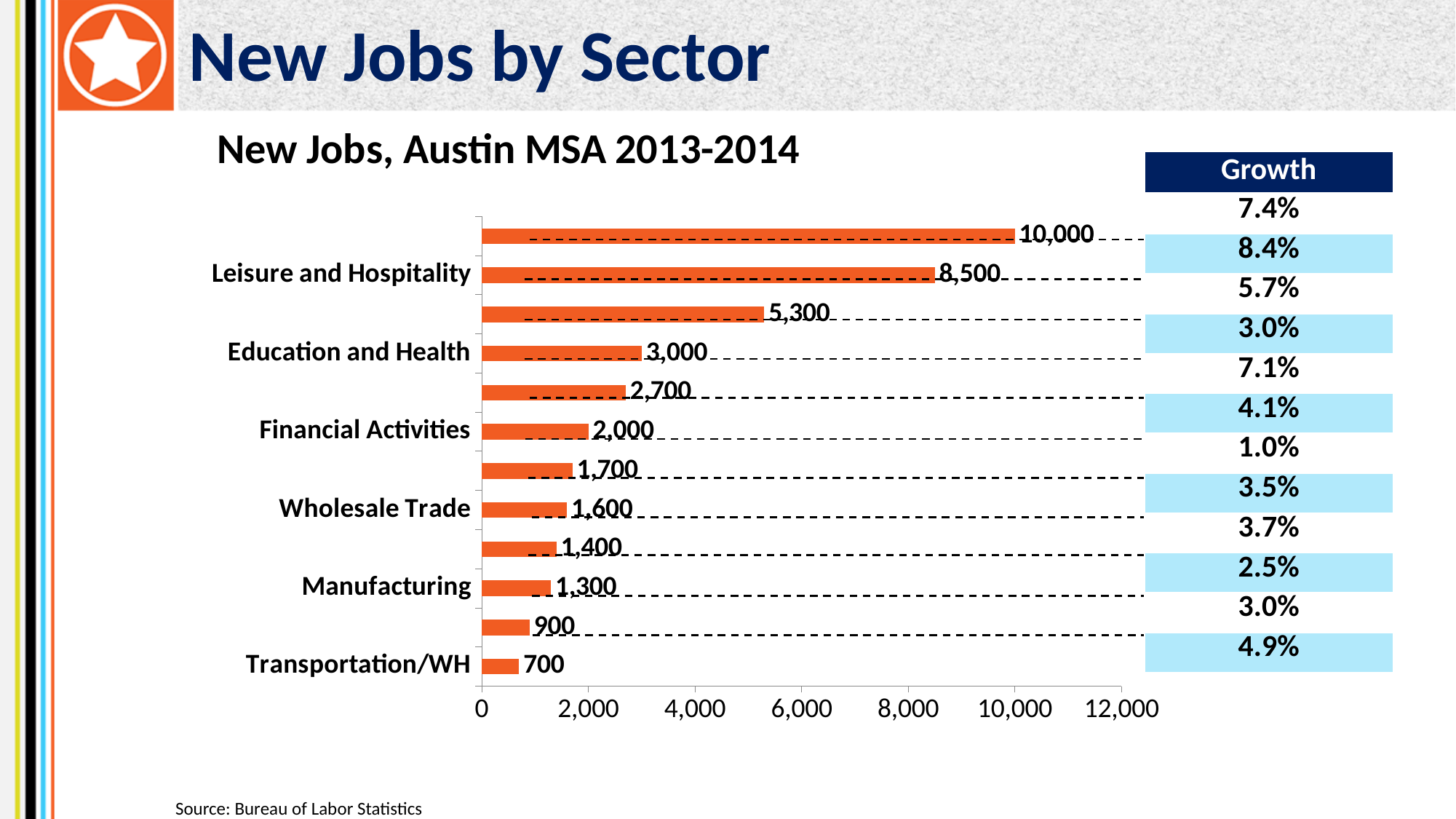
What is the difference in new jobs between Leisure and Hospitality and Education and Health? 5,500 Which labeled sector has the lowest number of new jobs? Transportation/WH How many new jobs are shown for Manufacturing? 1,300 What is the largest value shown on the chart? 10,000 How many new jobs are shown for Transportation/WH? 700 What type of chart is shown on the slide? bar chart How many new jobs are shown for Wholesale Trade? 1,600 How many new jobs are shown for Financial Activities? 2,000 What is the title of the chart? New Jobs, Austin MSA 2013-2014 How many new jobs are shown for Leisure and Hospitality? 8,500 How many bars are plotted on the chart? 12 How many new jobs are shown for Education and Health? 3,000